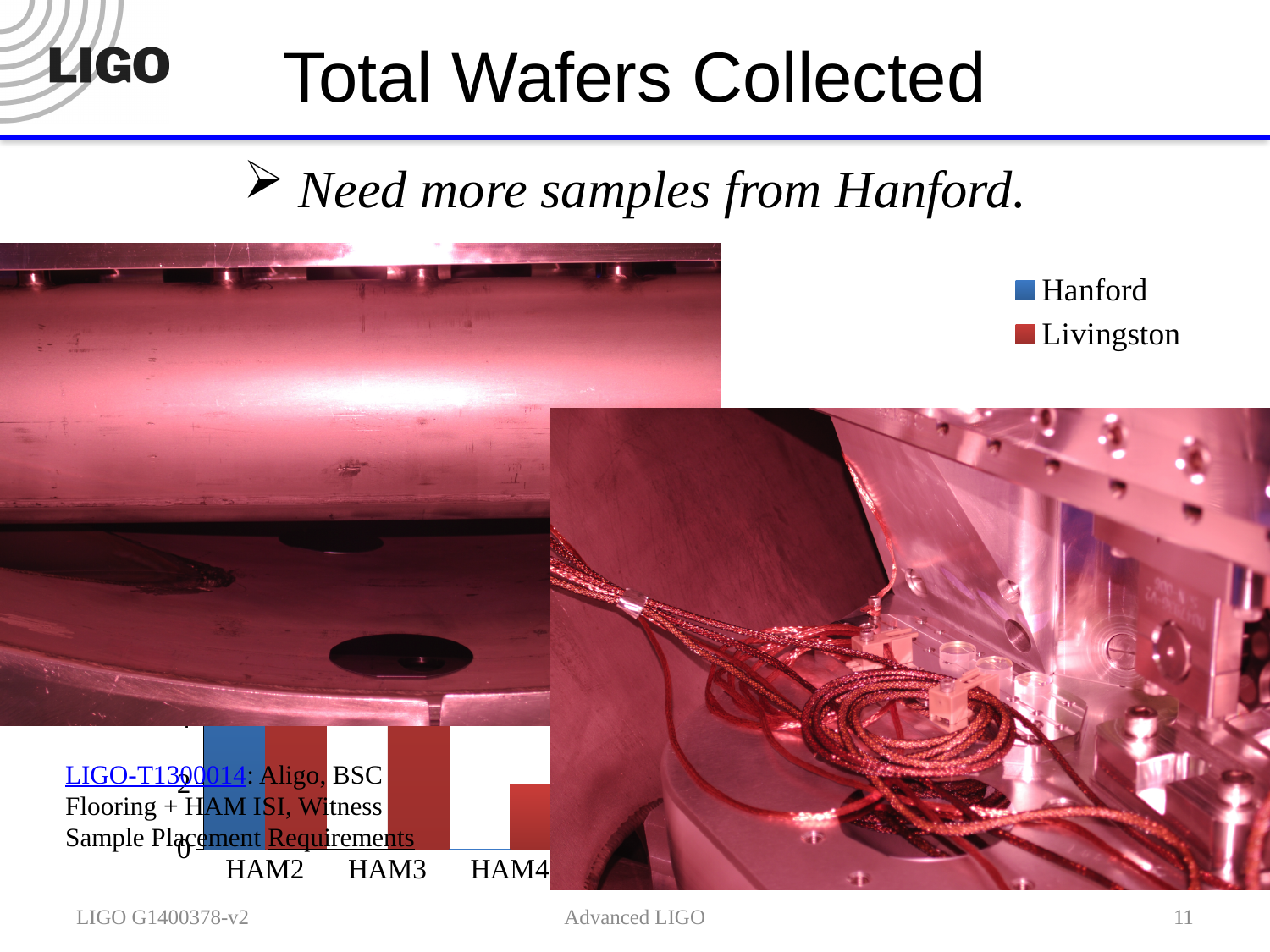
What are the two series named in the chart's legend? Hanford and Livingston What kind of chart is shown on the slide? bar chart How many series does the chart's legend list? 2 Which is larger, the Livingston value for HAM3 or the Livingston value for HAM4? HAM3 Is the Hanford value for HAM2 greater or less than 2? greater Is the Livingston value for HAM3 greater or less than 2? greater Which series is shown in blue in the chart? Hanford